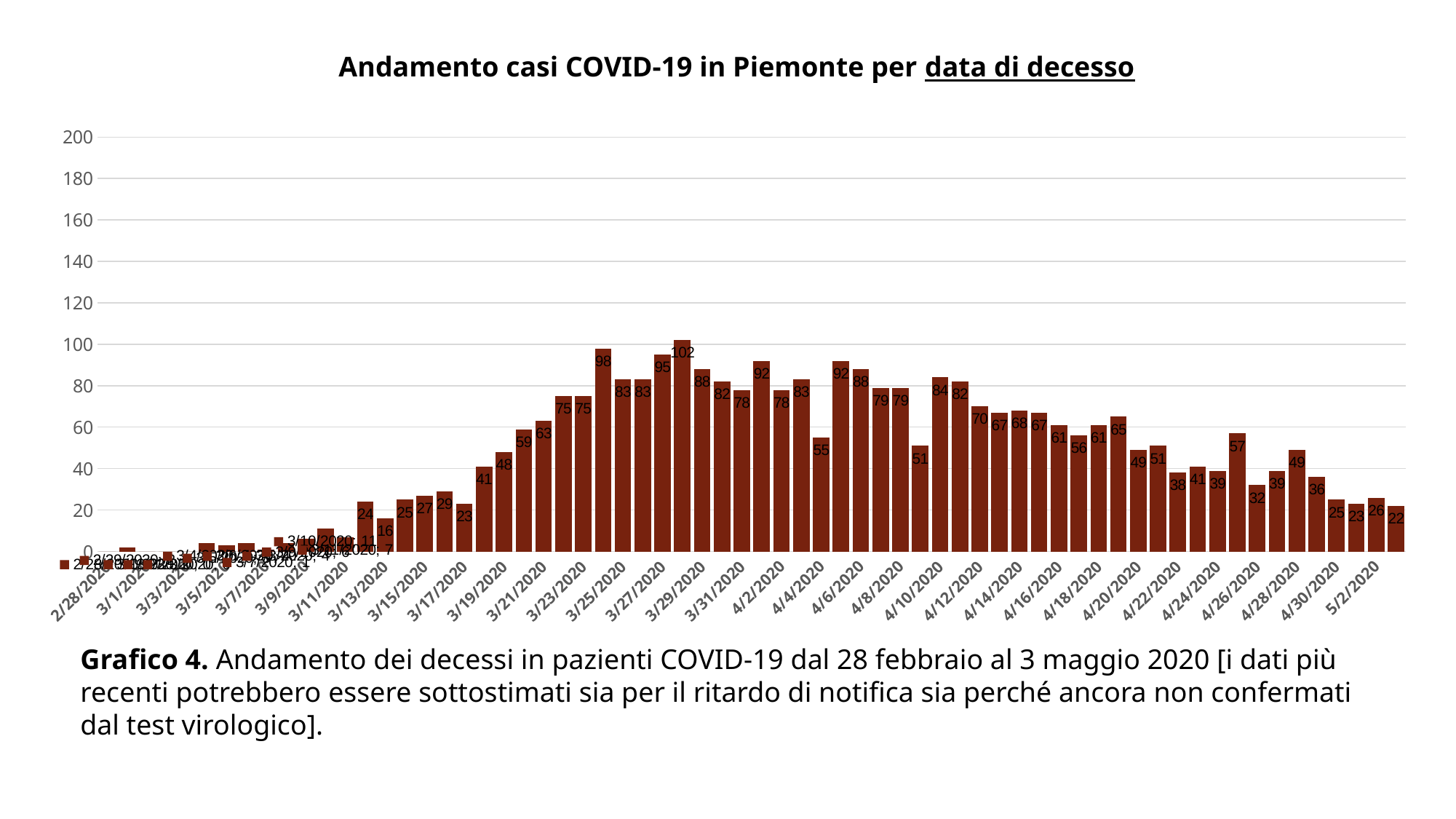
What is the value for 5/2/2020, the last date on the axis? 26 What is the value for 3/23/2020? 75 Is the value for 4/4/2020 greater or less than 80? less What kind of chart is shown on the slide? bar chart What is the title of the chart? Andamento casi COVID-19 in Piemonte per data di decesso What is the highest daily value shown in the chart? 102 What is the value for 4/8/2020? 79 Which date has the larger value, 3/27/2020 or 5/2/2020? 3/27/2020 Do the values generally rise or fall along the x axis from 4/10/2020 to 5/2/2020? fall What is the value for 3/27/2020? 95 Is the value for 4/30/2020 greater or less than 40? less